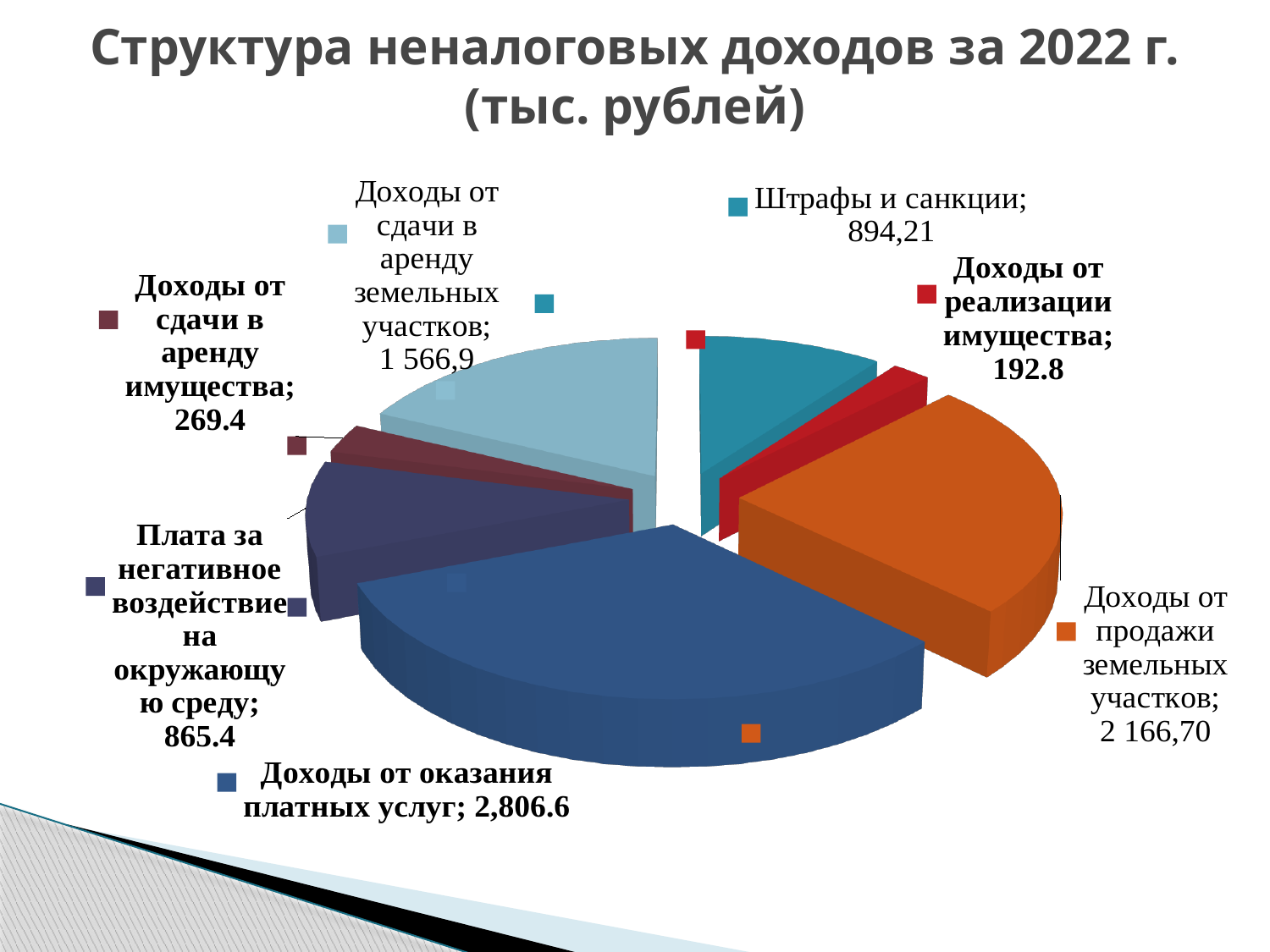
Which is larger: «Доходы от сдачи в аренду имущества» or «Доходы от реализации имущества»? Доходы от сдачи в аренду имущества How many categories (slices) does the pie chart have? 7 What is the value for «Доходы от оказания платных услуг»? 2,806.6 What is the value for «Доходы от сдачи в аренду земельных участков»? 1 566,9 What is the value for «Доходы от реализации имущества»? 192.8 Which category has the largest value? Доходы от оказания платных услуг What is the value for «Доходы от продажи земельных участков»? 2 166,70 What is the value for «Плата за негативное воздействие на окружающую среду»? 865.4 What type of chart is shown on the slide? Pie chart What is the value for «Штрафы и санкции»? 894,21 What is the difference between «Доходы от сдачи в аренду имущества» (269.4) and «Доходы от реализации имущества» (192.8)? 76.6 Which category has the smallest value? Доходы от реализации имущества